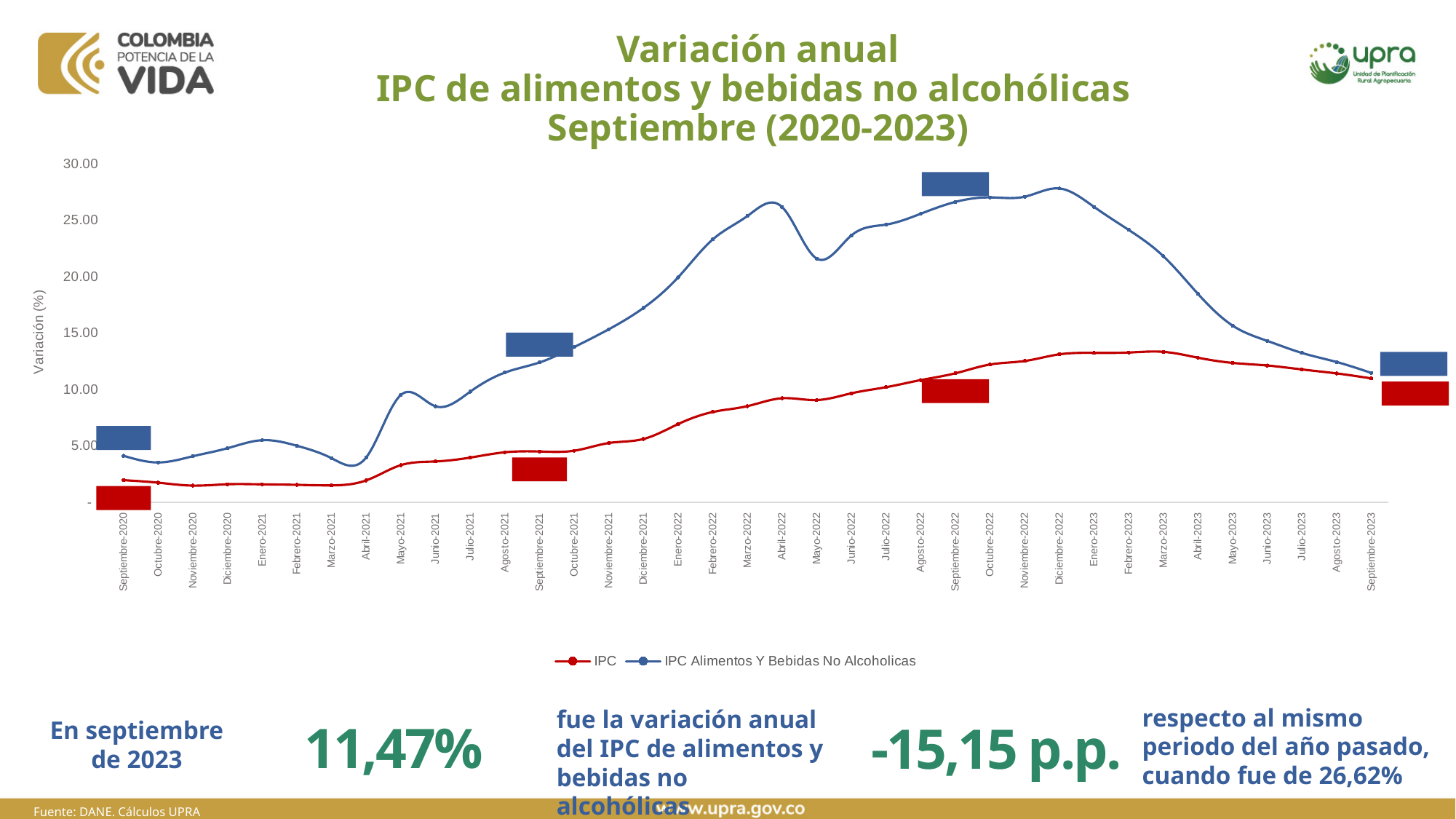
How many monthly points are plotted along the x axis, from Septiembre-2020 to Septiembre-2023? 37 By how many percentage points did the annual variation of the IPC de alimentos y bebidas no alcohólicas change between September 2022 and September 2023, as stated on the slide? -15,15 p.p. At Diciembre-2022, which series has the higher value: IPC or IPC Alimentos Y Bebidas No Alcoholicas? IPC Alimentos Y Bebidas No Alcoholicas How many series does the legend list? 2 What kind of chart is shown on the slide? line chart According to the slide, what was the annual variation of the IPC de alimentos y bebidas no alcohólicas in September 2022? 26,62% Is the value of the IPC Alimentos Y Bebidas No Alcoholicas series at Diciembre-2022 greater or less than 25.00? greater Is the value of the IPC series at Marzo-2023 greater or less than 10.00? greater What is the label on the vertical axis of the chart? Variación (%) Does the IPC Alimentos Y Bebidas No Alcoholicas series rise or fall from Diciembre-2022 to Septiembre-2023? fall Is the value of the IPC series at Septiembre-2020 greater or less than 5.00? less According to the slide, what was the annual variation of the IPC de alimentos y bebidas no alcohólicas in September 2023? 11,47%